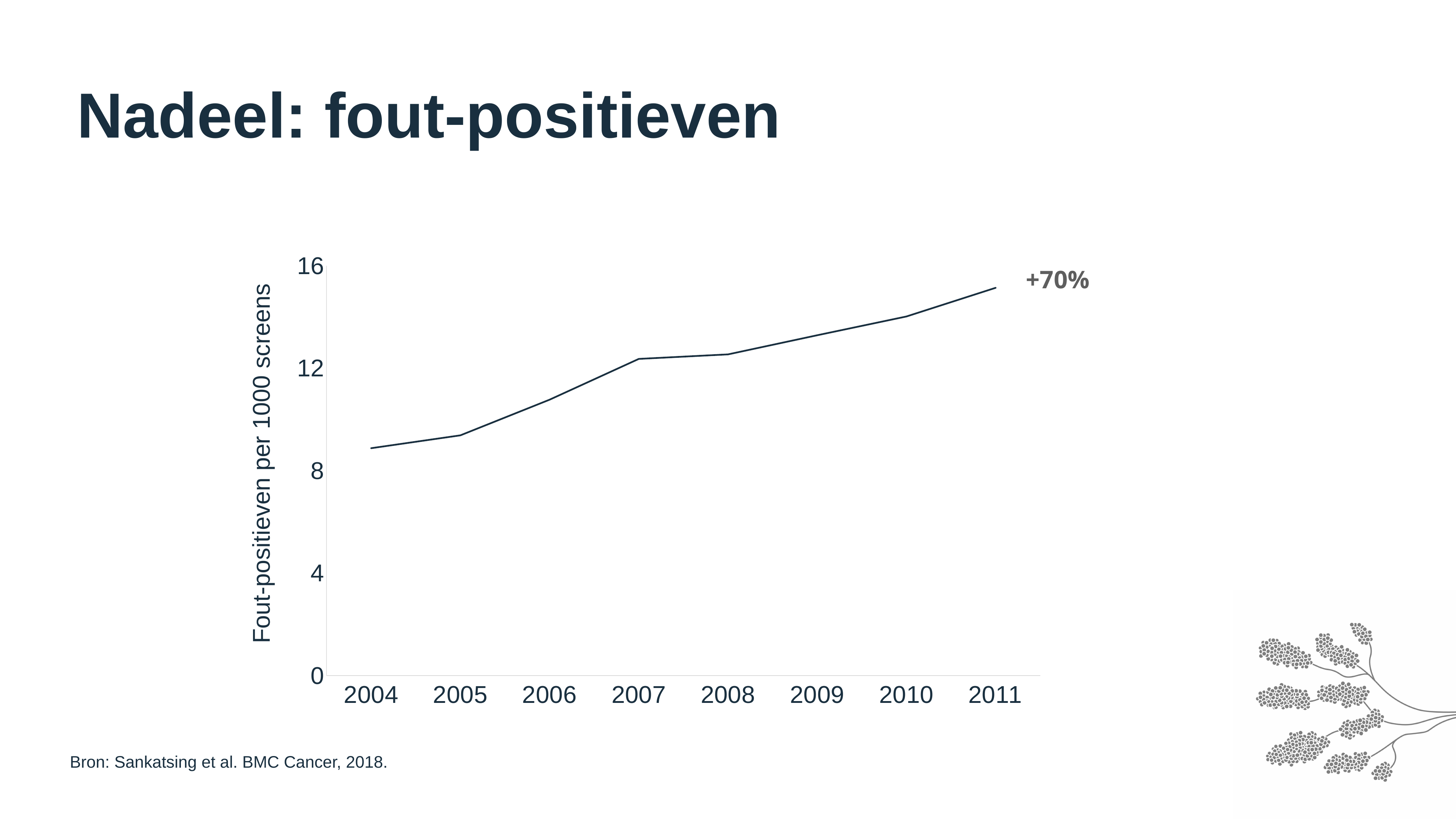
Is the value for 2004 greater or less than 8? greater Is the value for 2011 greater or less than 16? less What percentage change is annotated at the end of the line in the chart? +70% Is the value for 2004 greater or less than 12? less What kind of chart is shown on the slide? line chart Do the values in the chart rise or fall from 2004 to 2011? rise Which year has the larger value, 2006 or 2009? 2009 Which year has the highest value in the chart? 2011 What is the label on the y axis of the chart? Fout-positieven per 1000 screens How many years are plotted along the x axis of the chart? 8 Which year has the lowest value in the chart? 2004